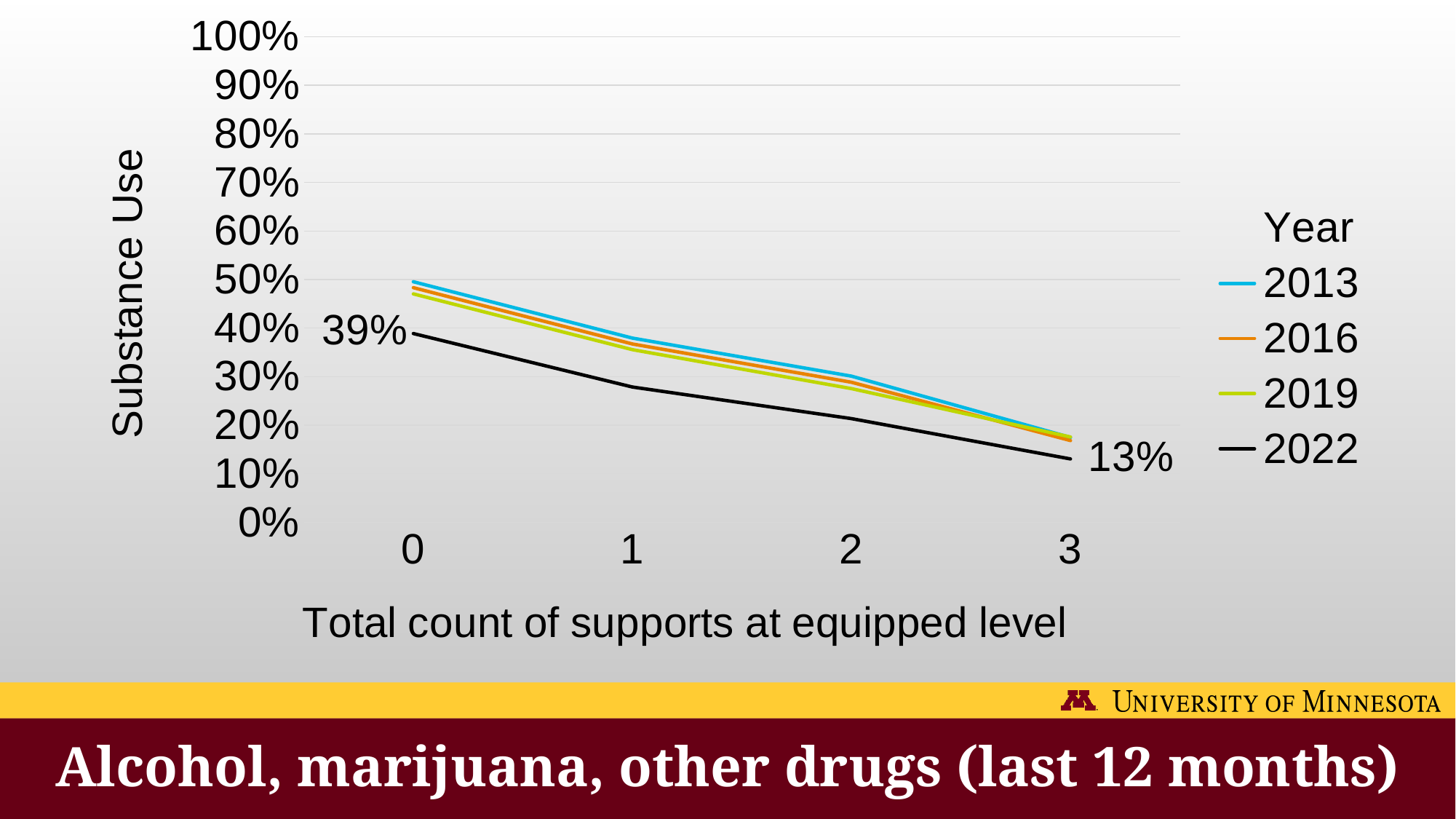
Is the value for 2013 at 0 supports greater or less than 40%? greater At 0 supports, which series has the lowest value? 2022 At 0 supports, which is larger: the value for 2013 or the value for 2022? 2013 Do the values rise or fall as the total count of supports increases? Fall How many series does the legend list? 4 What is the value for the 2022 series at 0 supports? 39% Is the value for 2022 at 2 supports greater or less than 30%? less What is the title of the y axis? Substance Use How many points are plotted along the x axis for each series? 4 What kind of chart is shown on the slide? Line chart What is the value for the 2022 series at 3 supports? 13% What is the difference between the 2022 values at 0 supports and at 3 supports? 26 percentage points